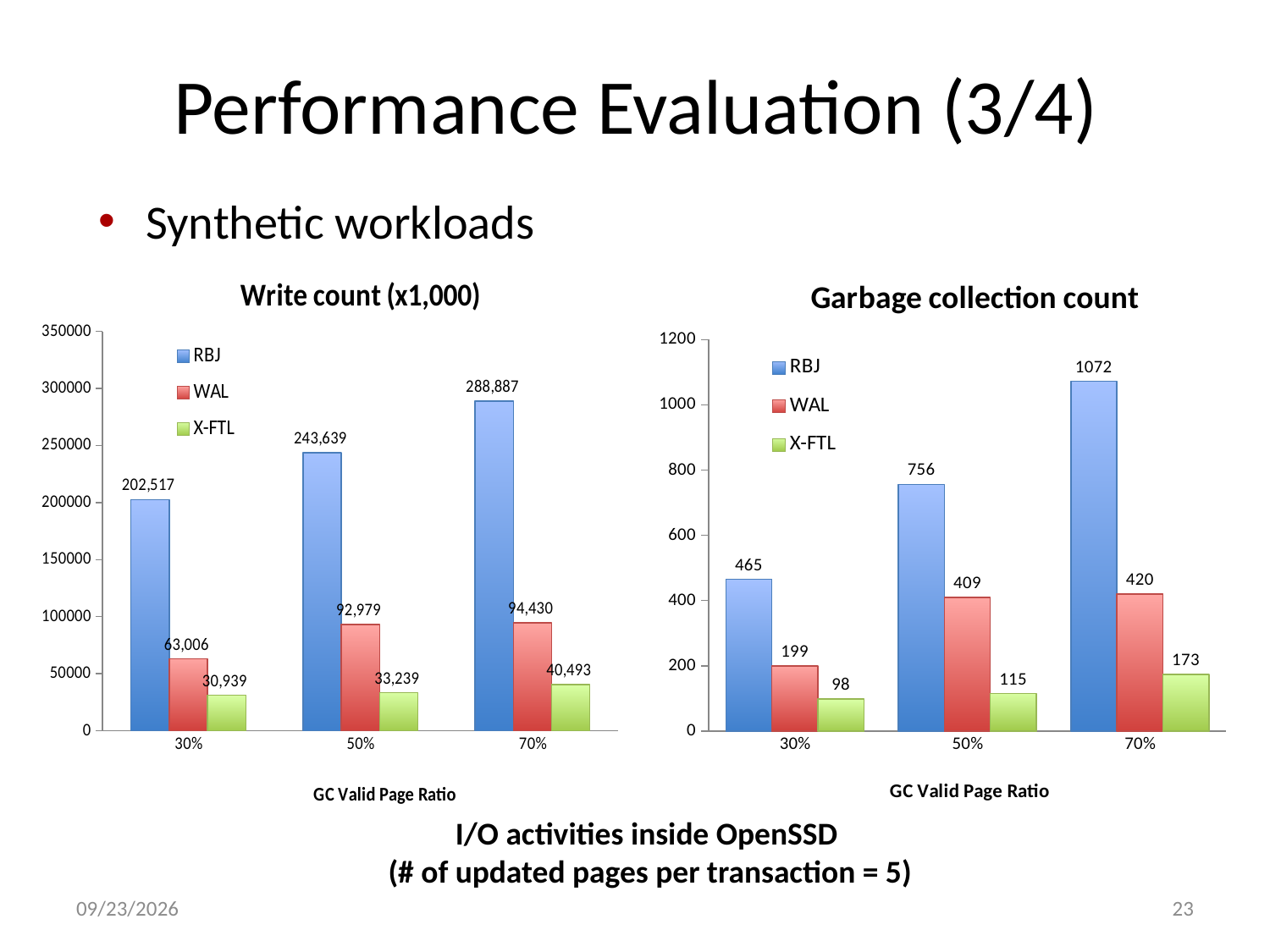
In the Write count (x1,000) chart, what is the difference between WAL at 70% and WAL at 50%? 1,451 In the Write count (x1,000) chart, what is the value for RBJ at 50%? 243,639 In the Garbage collection count chart, which series has the highest value at 70%? RBJ In the Write count (x1,000) chart, is the value for RBJ at 70% greater or less than 250000? greater What kind of chart is the Write count (x1,000) chart? bar chart In the Garbage collection count chart, what is the difference between RBJ and WAL at 50%? 347 In the Garbage collection count chart, what is the value for WAL at 30%? 199 In the Write count (x1,000) chart, which series has the lowest value at 30%? X-FTL In the Write count (x1,000) chart, what is the value for X-FTL at 70%? 40,493 In the Garbage collection count chart, is the value for X-FTL at 50% larger or smaller than the value for X-FTL at 70%? smaller In the Garbage collection count chart, do the RBJ values rise or fall as the GC Valid Page Ratio increases from 30% to 70%? rise How many series does the legend of the Garbage collection count chart list? 3